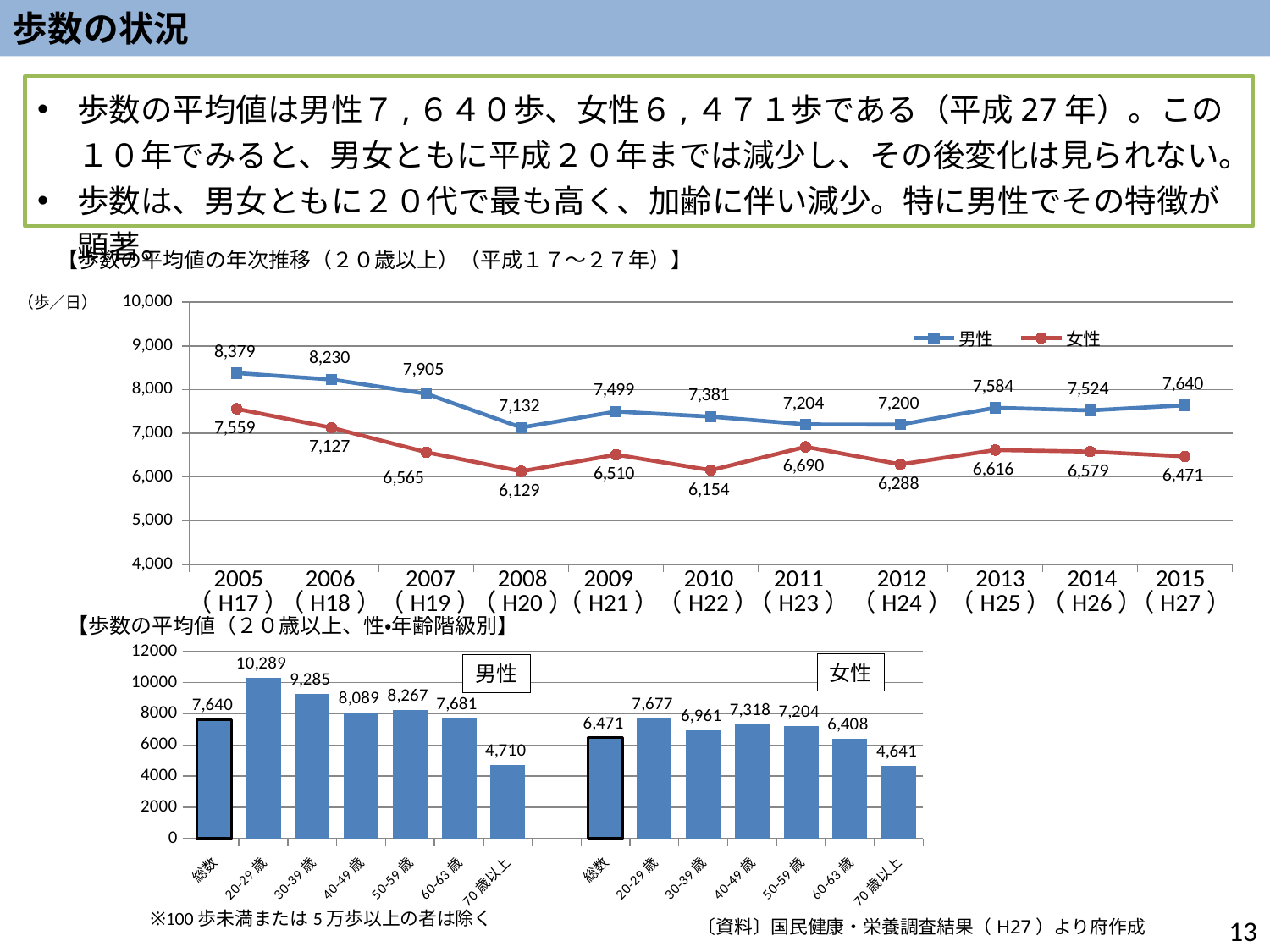
In the top line chart (歩数の平均値の年次推移), how many series does the legend list? 2 In the top line chart (歩数の平均値の年次推移), what kind of chart is it? Line chart In the top line chart (歩数の平均値の年次推移), what is the value for 男性 in 2015 (H27)? 7,640 In the bottom bar chart (歩数の平均値 性・年齢階級別), which is larger: 男性 40-49歳 or 男性 50-59歳? 男性 50-59歳 In the top line chart (歩数の平均値の年次推移), what is the difference between 男性 and 女性 in 2005 (H17)? 820 In the top line chart (歩数の平均値の年次推移), which year has the highest value for 男性? 2005 (H17) In the bottom bar chart (歩数の平均値 性・年齢階級別), what is the difference between 男性 総数 and 女性 総数? 1,169 In the top line chart (歩数の平均値の年次推移), which year has the lowest value for 女性? 2008 (H20) In the top line chart (歩数の平均値の年次推移), does the 男性 series rise or fall from 2005 to 2008? Fall In the bottom bar chart (歩数の平均値 性・年齢階級別), which age group has the lowest value for 女性? 70歳以上 In the top line chart (歩数の平均値の年次推移), what is the value for 女性 in 2008 (H20)? 6,129 In the bottom bar chart (歩数の平均値 性・年齢階級別), what is the value for 男性 20-29歳? 10,289